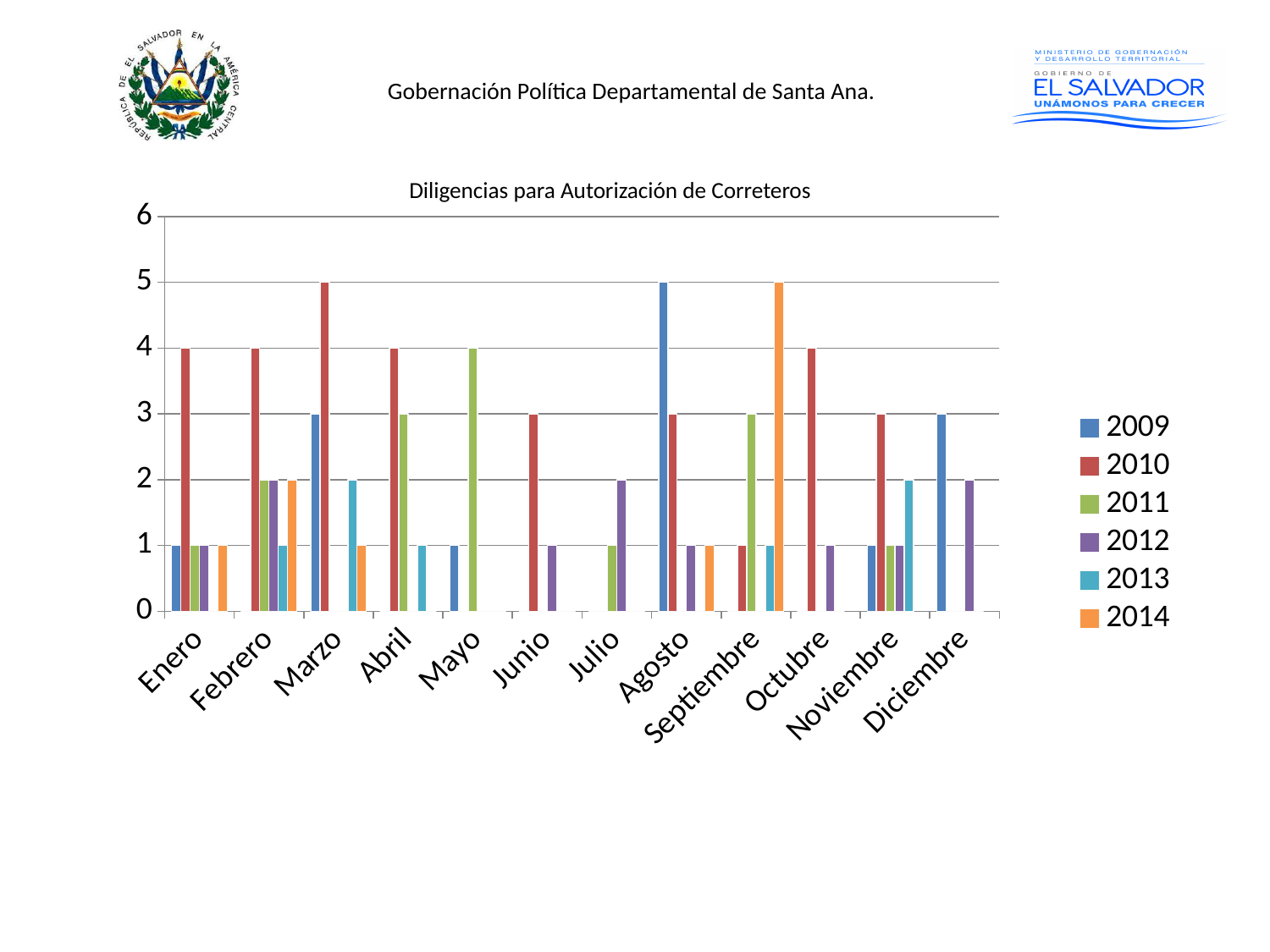
How many series does the legend list? 6 In which month does the 2010 series reach its highest value? Marzo What is the value for 2012 in Diciembre? 2 What is the title of the chart? Diligencias para Autorización de Correteros What is the value for 2011 in Mayo? 4 Which is larger in Abril, the value for 2010 or the value for 2011? 2010 How many months are shown along the x axis? 12 What is the value for 2014 in Septiembre? 5 What kind of chart is shown on the slide? bar chart What is the value for 2009 in Agosto? 5 What is the value for 2010 in Marzo? 5 What is the difference between the 2010 value and the 2009 value in Enero? 3